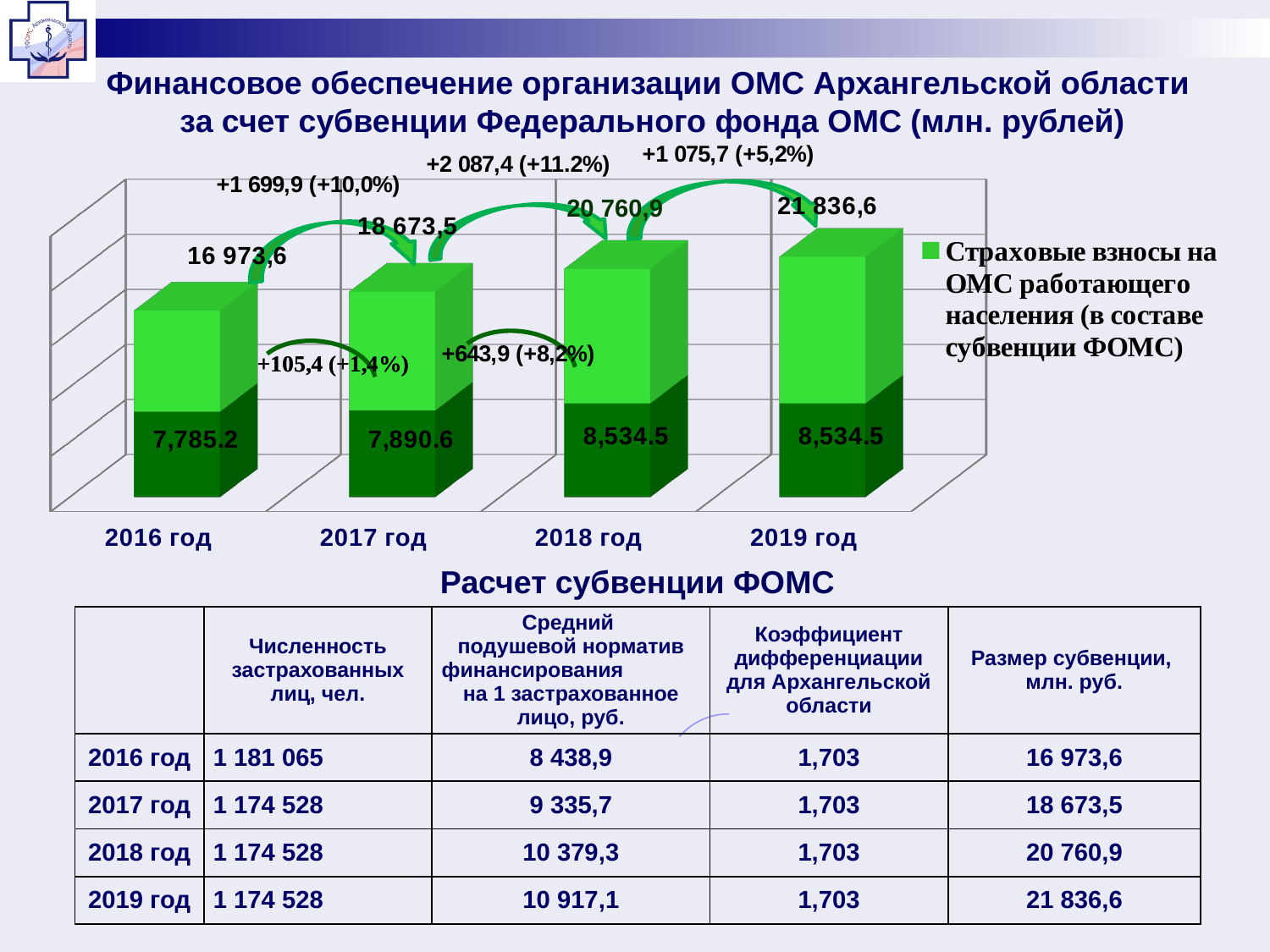
What is the total subvention value labelled above the bar for 2019 год? 21 836,6 What is the legend entry shown to the right of the chart? Страховые взносы на ОМС работающего населения (в составе субвенции ФОМС) What kind of chart is shown on the slide? bar chart What is the total subvention value labelled above the bar for 2016 год? 16 973,6 By how much does the total labelled for 2018 год exceed the total for 2017 год, according to the arrow annotation? +2 087,4 (+11.2%) Is the dark green segment value for 2019 год larger or smaller than the dark green segment value for 2017 год? larger Which year has the lowest value printed on its dark green segment? 2016 год What value is printed on the dark green segment of the 2018 год bar? 8,534.5 What value is printed on the dark green segment of the 2017 год bar? 7,890.6 Which year has the highest total subvention value labelled on the chart? 2019 год How many years (categories) are shown on the x axis of the chart? 4 Do the total subvention values labelled above the bars rise or fall from 2016 год to 2019 год? rise